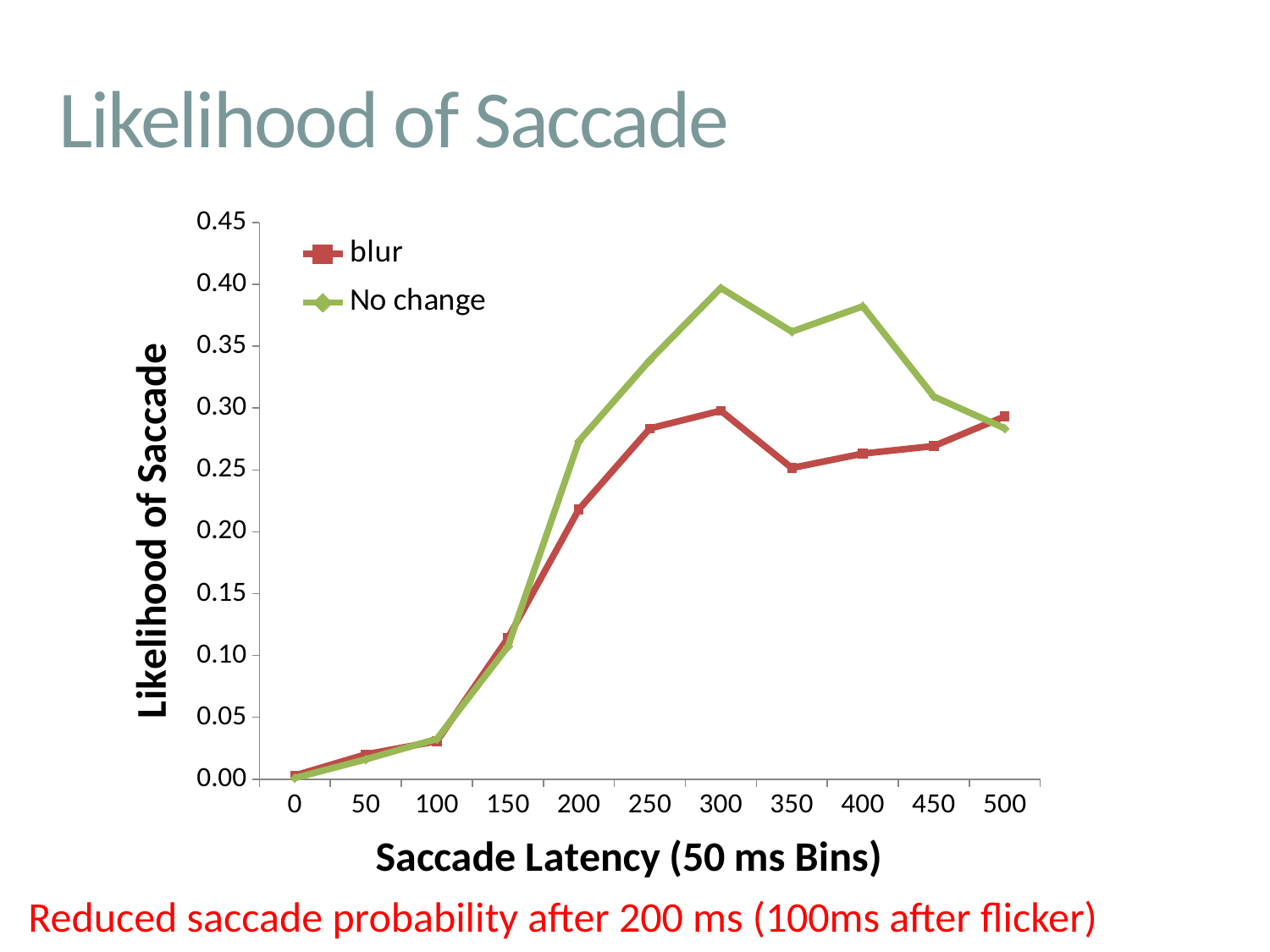
How many saccade latency bins are plotted along the x axis? 11 Is the value for blur at a saccade latency of 350 greater or less than 0.30? less Is the value for blur at a saccade latency of 150 greater or less than 0.15? less What kind of chart is shown on the slide? line chart At a saccade latency of 300, which series has the larger value, blur or No change? No change At which saccade latency does the No change series reach its highest value? 300 Does the blur series rise or fall between saccade latencies of 0 and 300? rise Is the value for No change at a saccade latency of 300 greater or less than 0.35? greater At a saccade latency of 400, which series has the larger value, blur or No change? No change What is the title of the x axis? Saccade Latency (50 ms Bins) How many series does the legend list? 2 Does the No change series rise or fall between saccade latencies of 400 and 500? fall